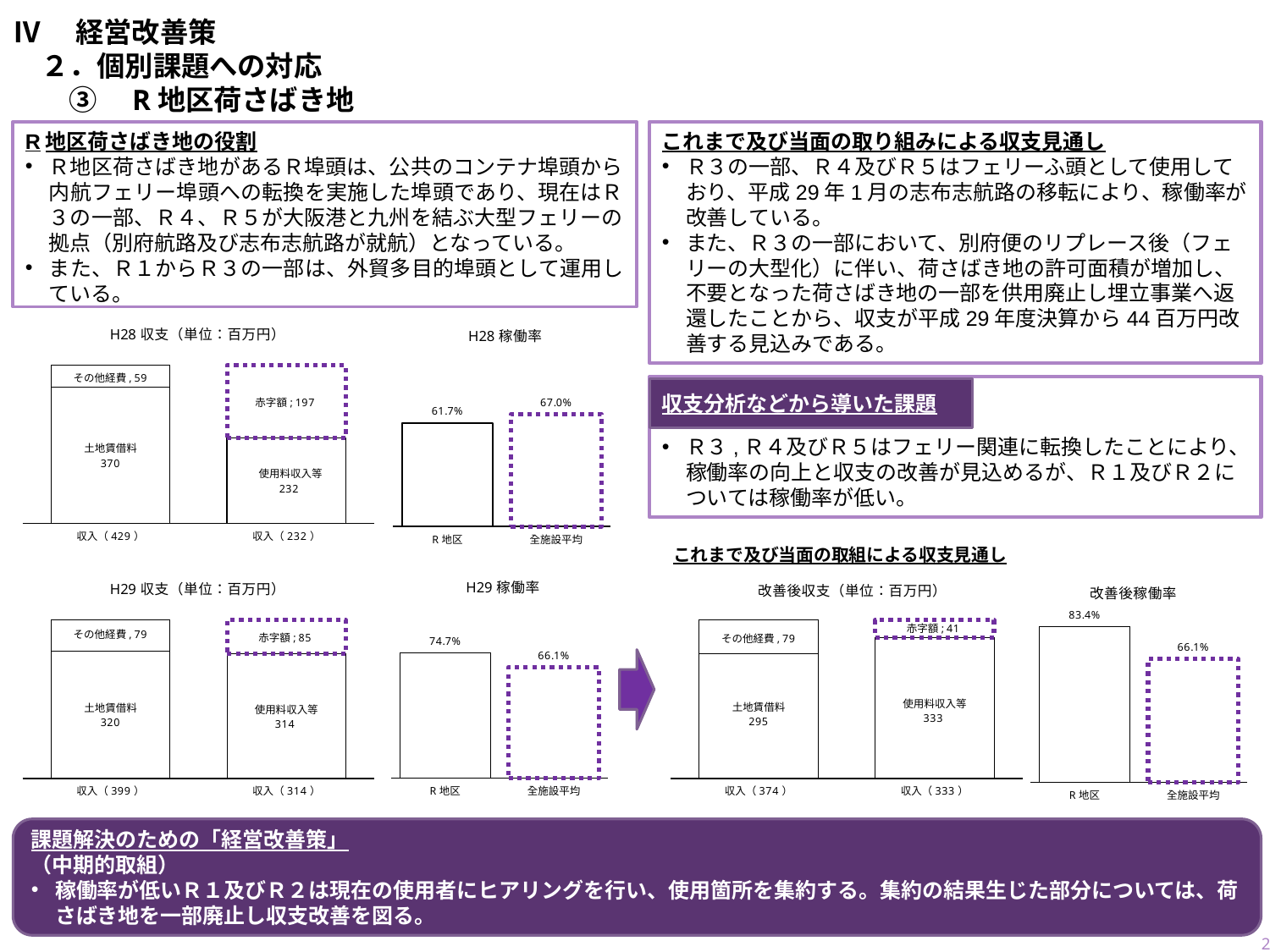
「H28 収支」のグラフで、土地賃借料の値はいくらですか？ 370 「H29 稼働率」のグラフで、R地区と全施設平均の稼働率の差は何ポイントですか？ 8.6 「改善後稼働率」のグラフで、R地区と全施設平均ではどちらの稼働率が高いですか？ R地区 「H29 収支」のグラフで、その他経費と土地賃借料を合わせた収入の合計はいくらですか？ 399 「H28 収支」のグラフで、赤字額はいくらですか？ 197 「改善後収支」のグラフで、土地賃借料の値はいくらですか？ 295 「改善後稼働率」のグラフで、R地区の稼働率は何%ですか？ 83.4% 「改善後収支」のグラフで、赤字額はいくらですか？ 41 「H28 稼働率」のグラフで、R地区と全施設平均ではどちらの稼働率が高いですか？ 全施設平均 「H29 収支」のグラフで、使用料収入等の値はいくらですか？ 314 「H28 稼働率」のグラフで、R地区の稼働率は何%ですか？ 61.7% 「H28 稼働率」のグラフはどの種類のグラフですか？ 棒グラフ